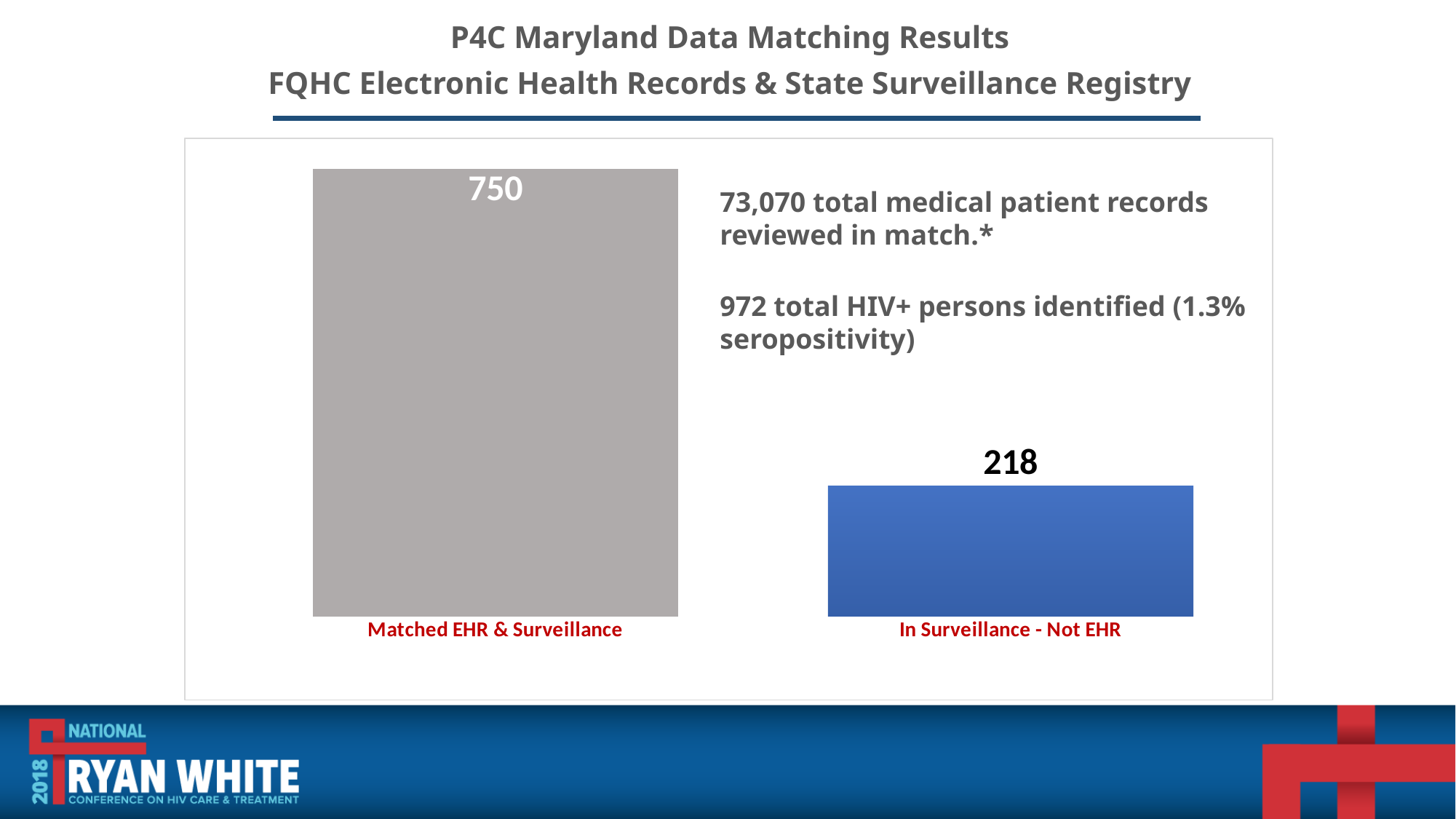
What colour is the bar for Matched EHR & Surveillance? Gray What is the value for In Surveillance - Not EHR? 218 What is the value for Matched EHR & Surveillance? 750 Which category has the lowest value? In Surveillance - Not EHR What is the total of the two bars in the chart? 968 Which is larger: Matched EHR & Surveillance or In Surveillance - Not EHR? Matched EHR & Surveillance What is the difference between the values for Matched EHR & Surveillance and In Surveillance - Not EHR? 532 How many categories are shown in the chart? 2 Which category has the highest value? Matched EHR & Surveillance What colour is the bar for In Surveillance - Not EHR? Blue What kind of chart is shown on the slide? Bar chart